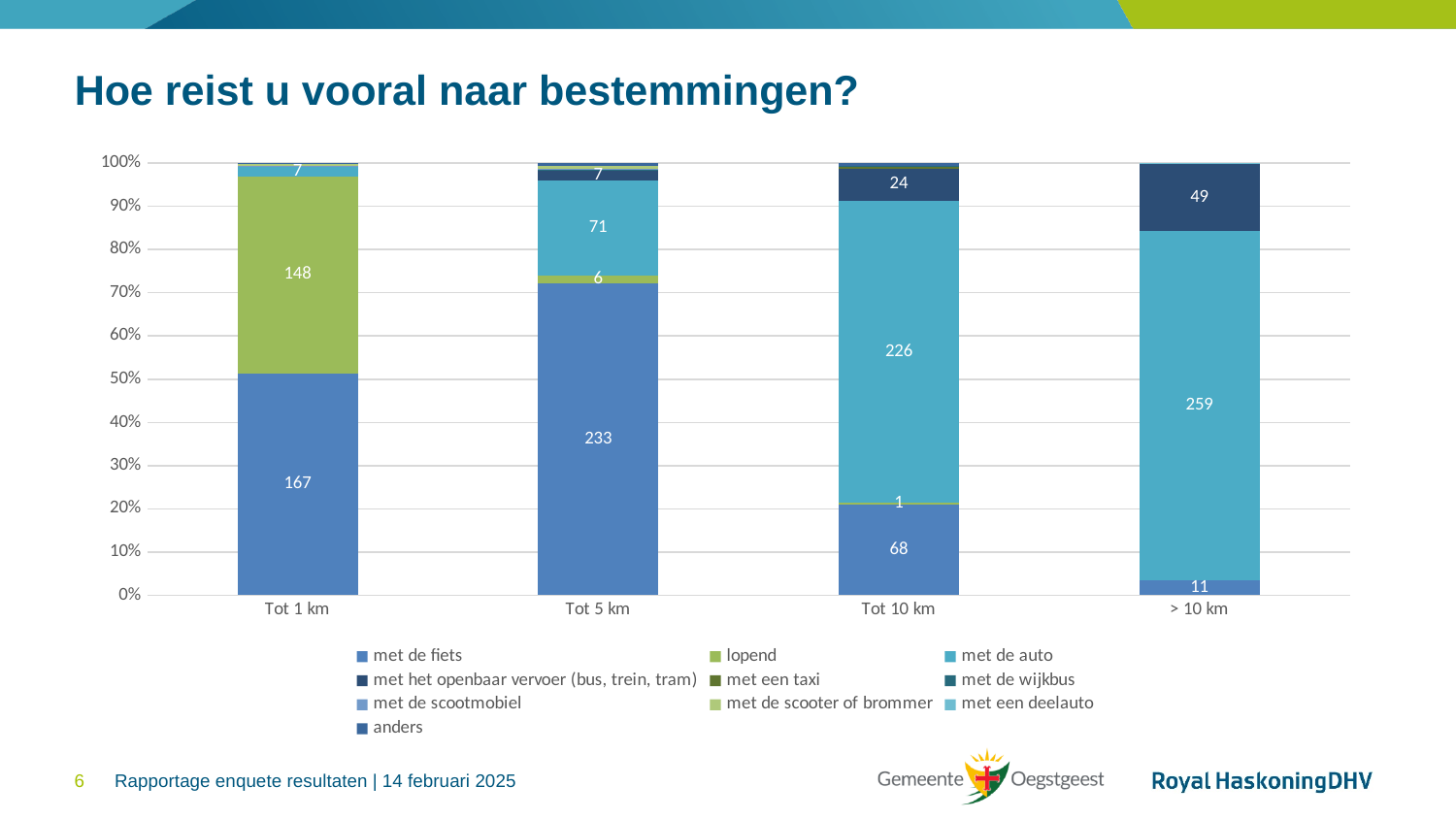
Do the values for 'met de auto' rise or fall from 'Tot 1 km' to '> 10 km'? Rise What is the value for 'met het openbaar vervoer (bus, trein, tram)' in the 'Tot 10 km' category? 24 What is the value for 'met de fiets' in the 'Tot 5 km' category? 233 How many distance categories are shown on the x axis? 4 Which distance category has the lowest value for 'met de fiets'? > 10 km What kind of chart is shown on the slide? Stacked bar chart How many series does the legend list? 10 What is the value for 'met de auto' in the '> 10 km' category? 259 What is the value for 'lopend' in the 'Tot 1 km' category? 148 Which distance category has the highest value for 'met de fiets'? Tot 5 km In the 'Tot 1 km' category, which is larger: 'met de fiets' or 'lopend'? met de fiets What is the difference between the 'met de auto' values for 'Tot 10 km' and 'Tot 5 km'? 155